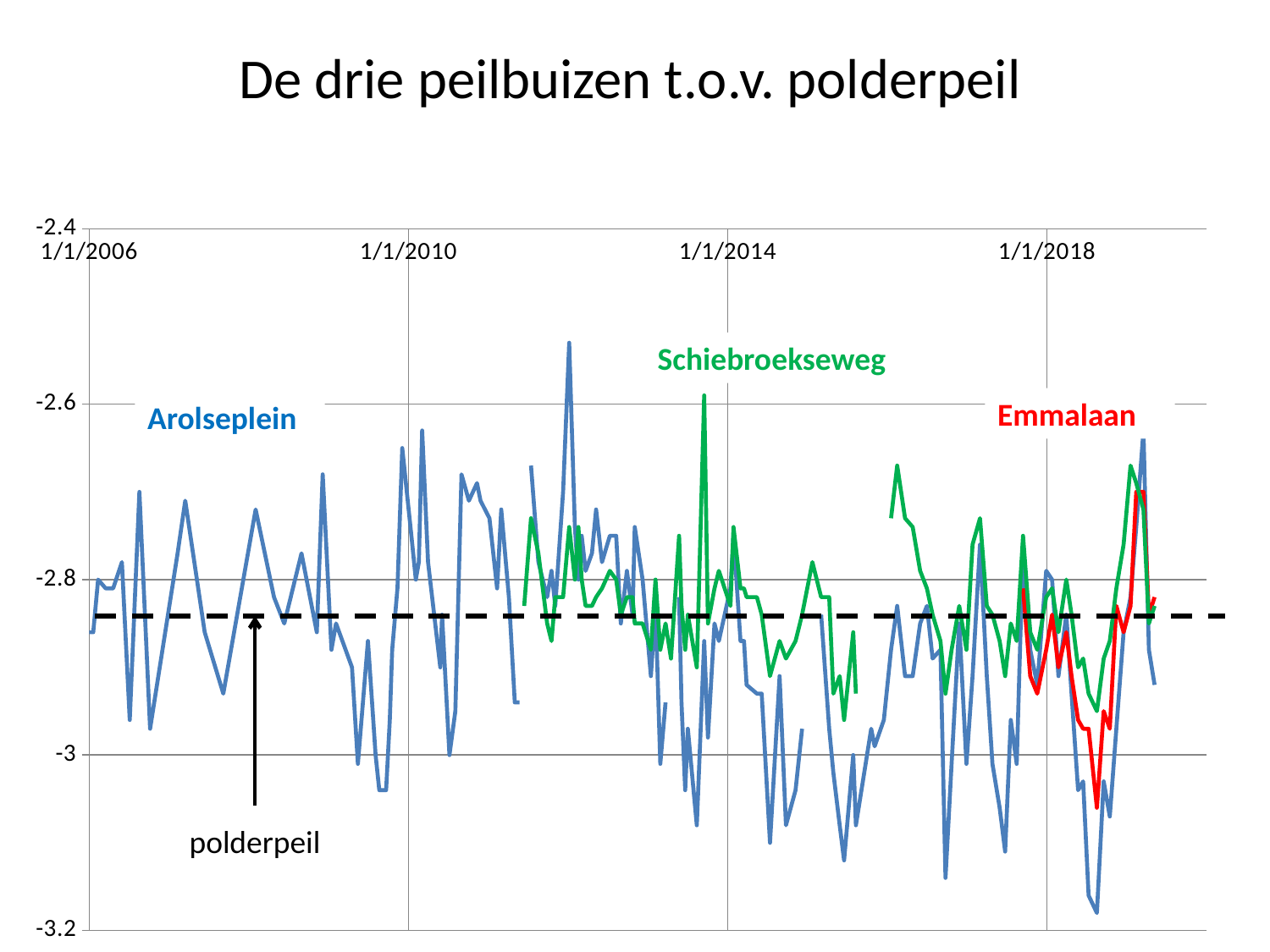
Is the polderpeil dashed line above or below -2.8? below What is the title of the chart? De drie peilbuizen t.o.v. polderpeil Which series reaches the highest value on the chart? Arolseplein Which series starts latest along the x axis? Emmalaan What kind of chart is shown on the slide? line chart How many data series are labelled on the chart? 3 Is the highest peak of the Arolseplein series greater or less than -2.6? greater What does the black dashed horizontal line represent? polderpeil Is the lowest value of the Emmalaan series greater or less than -3? less Which series starts earliest along the x axis? Arolseplein Which series reaches the lowest value on the chart? Arolseplein